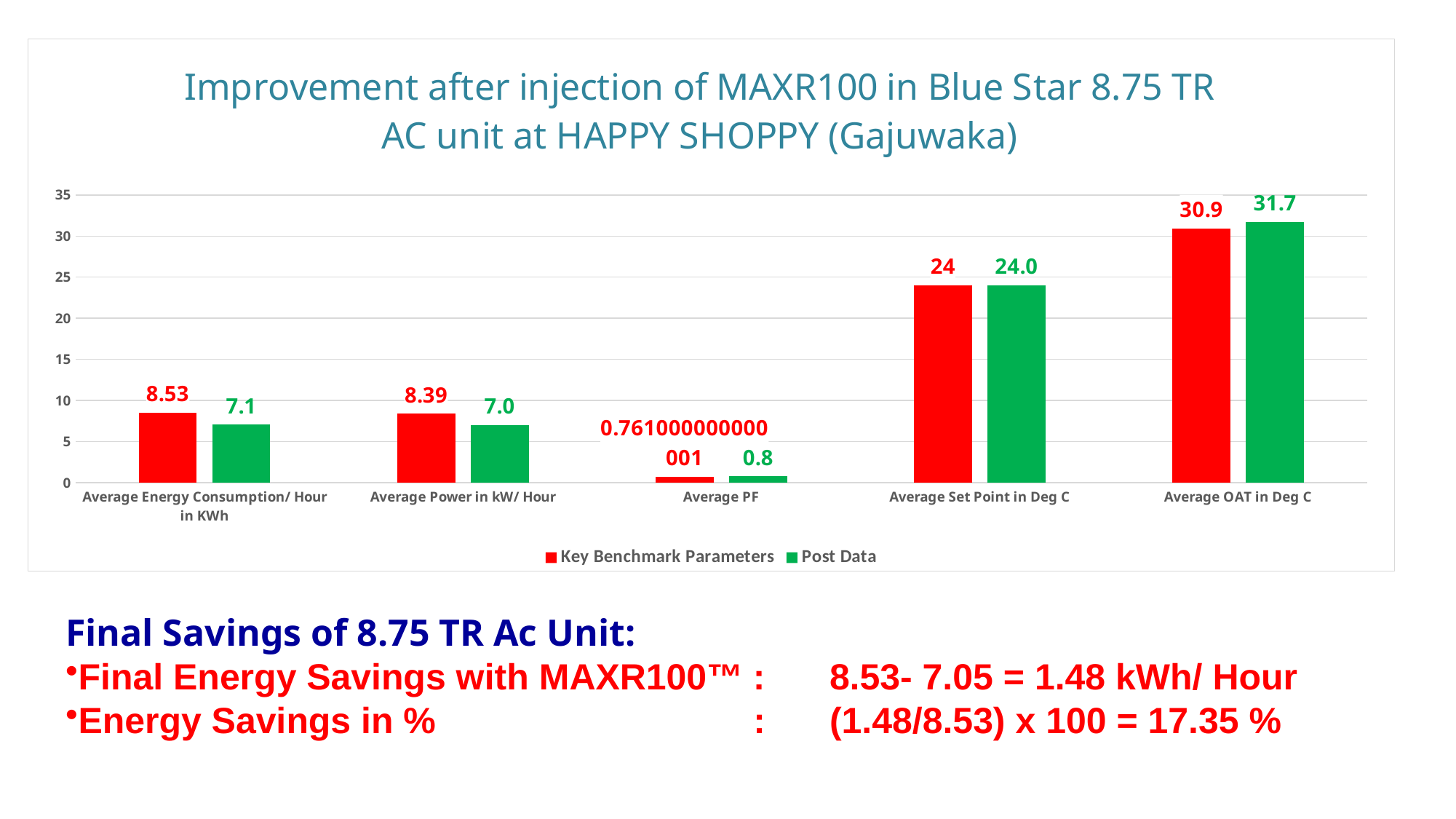
Is the Post Data value for Average Set Point in Deg C greater or less than 20? greater For Average Energy Consumption/ Hour in KWh, which is larger: the Key Benchmark Parameters value or the Post Data value? Key Benchmark Parameters What is the difference between the Key Benchmark Parameters and Post Data values for Average OAT in Deg C? 0.8 What is the Post Data value for Average Power in kW/ Hour? 7.0 Which category has the highest Post Data value? Average OAT in Deg C How many categories are shown on the x axis? 5 What is the Post Data value for Average OAT in Deg C? 31.7 What is the Key Benchmark Parameters value for Average Set Point in Deg C? 24 What kind of chart is shown on the slide? bar chart What is the Key Benchmark Parameters value for Average Energy Consumption/ Hour in KWh? 8.53 Which category has the lowest Key Benchmark Parameters value? Average PF How many series does the legend list? 2